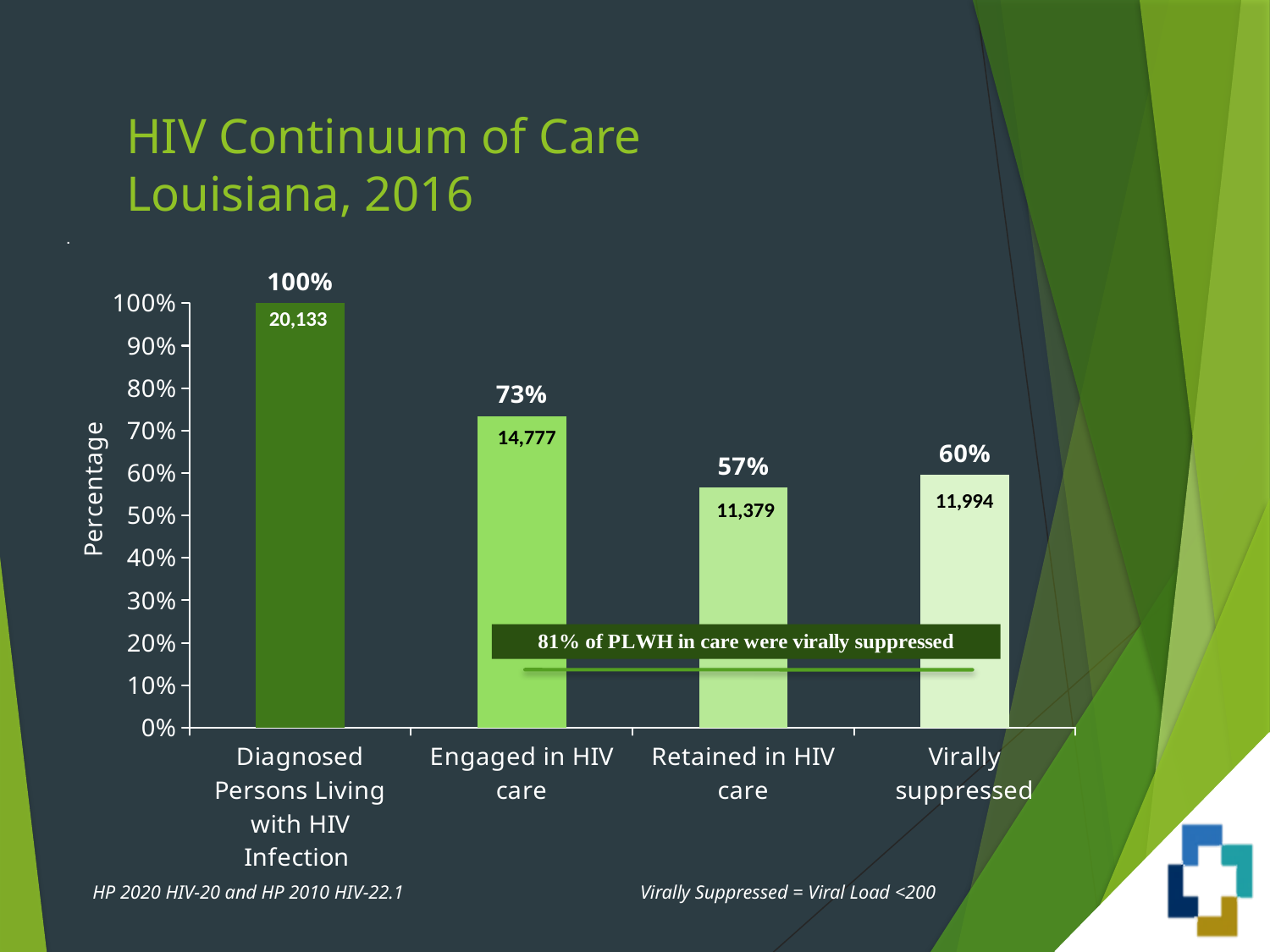
What percentage is shown for Virally suppressed? 60% How many categories are shown on the x axis? 4 What is the label of the y axis? Percentage What is the count shown inside the bar for Retained in HIV care? 11,379 What does the text box overlaid on the chart say? 81% of PLWH in care were virally suppressed What percentage is shown for Engaged in HIV care? 73% Which category has the highest percentage? Diagnosed Persons Living with HIV Infection What kind of chart is this? Bar chart Which category has the lowest percentage? Retained in HIV care What is the difference in percentage points between Engaged in HIV care and Retained in HIV care? 16 Which is larger, the percentage for Virally suppressed or for Retained in HIV care? Virally suppressed What is the count shown inside the bar for Diagnosed Persons Living with HIV Infection? 20,133